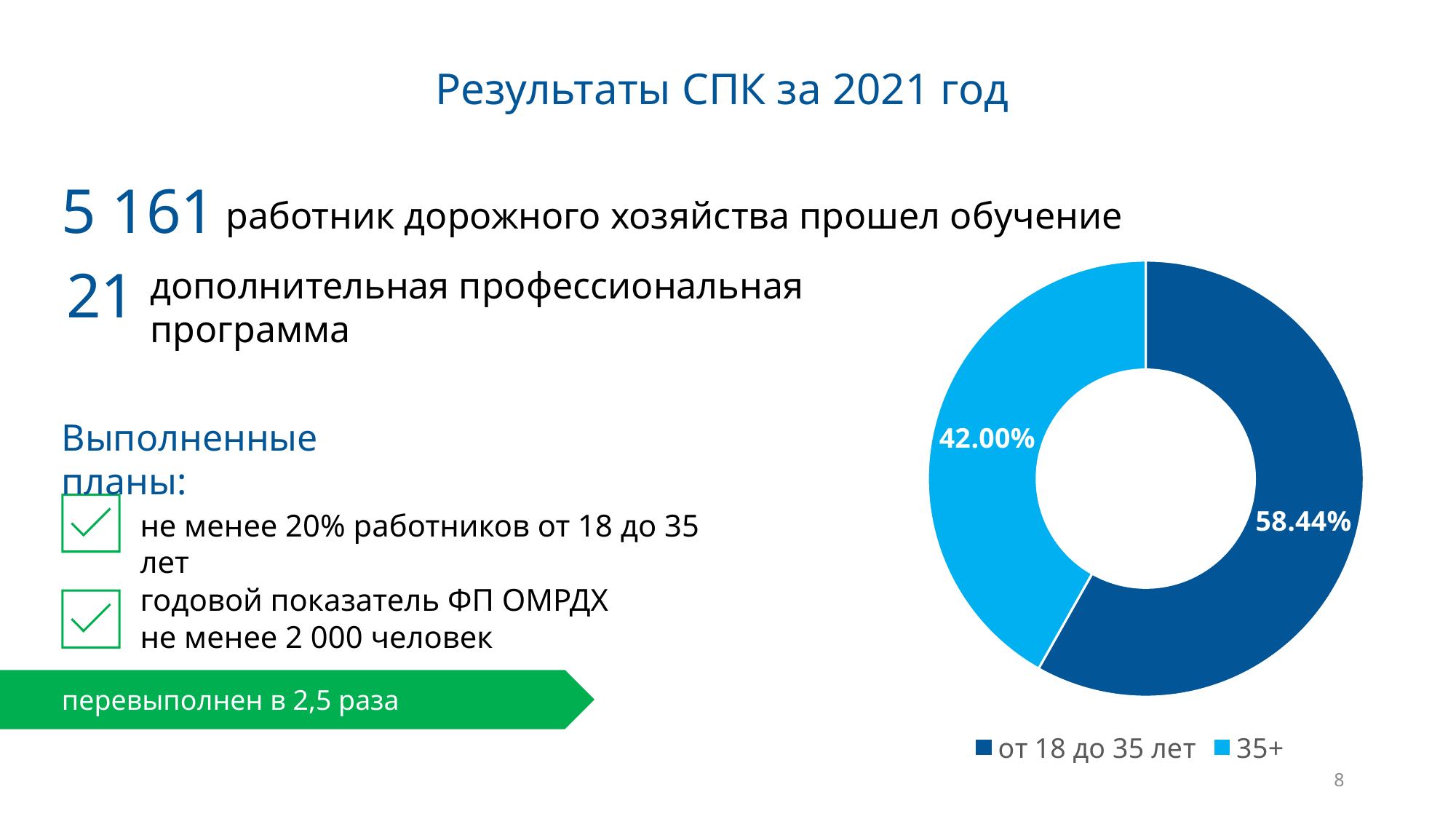
What colour represents the "35+" category in the chart? Light blue Which category has the smallest share in the doughnut chart? 35+ How many entries does the chart legend list? 2 Which category has the largest share in the doughnut chart? от 18 до 35 лет What share of the doughnut chart is labelled for the category "от 18 до 35 лет"? 58.44% Is the share for "35+" greater or less than 50%? less How many categories are shown in the doughnut chart? 2 Which legend entry is shown in dark blue? от 18 до 35 лет Which is larger in the doughnut chart: the share for "от 18 до 35 лет" or the share for "35+"? от 18 до 35 лет What is the difference in percentage points between the "от 18 до 35 лет" share and the "35+" share? 16.44 What share of the doughnut chart is labelled for the category "35+"? 42.00% What type of chart is shown on the slide? Doughnut (pie) chart